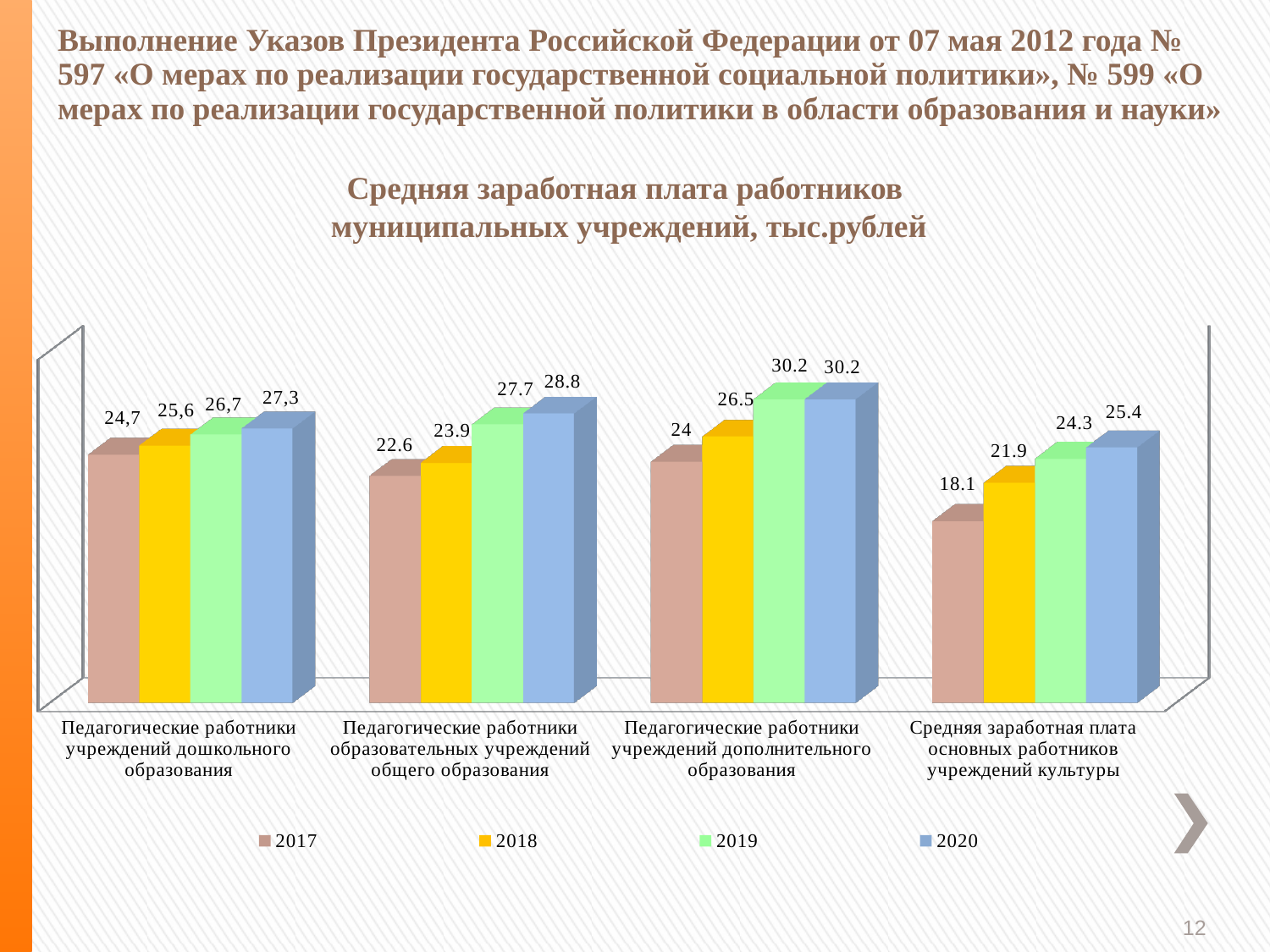
What is the difference between the 2020 and 2017 values for Средняя заработная плата основных работников учреждений культуры? 7.3 Do the values for Педагогические работники образовательных учреждений общего образования rise or fall from 2017 to 2020? Rise Which category has the lowest value for 2017? Средняя заработная плата основных работников учреждений культуры What is the value for 2018 for Средняя заработная плата основных работников учреждений культуры? 21.9 How many categories are shown on the x axis? 4 How many series does the legend list? 4 What is the value for 2019 for Педагогические работники учреждений дополнительного образования? 30.2 Which is larger for 2019: Педагогические работники образовательных учреждений общего образования or Педагогические работники учреждений дошкольного образования? Педагогические работники образовательных учреждений общего образования What kind of chart is shown on the slide? Bar chart What is the value for 2017 for Педагогические работники образовательных учреждений общего образования? 22.6 Which category has the highest value for 2020? Педагогические работники учреждений дополнительного образования What is the average salary for 2020 for Педагогические работники учреждений дошкольного образования? 27,3